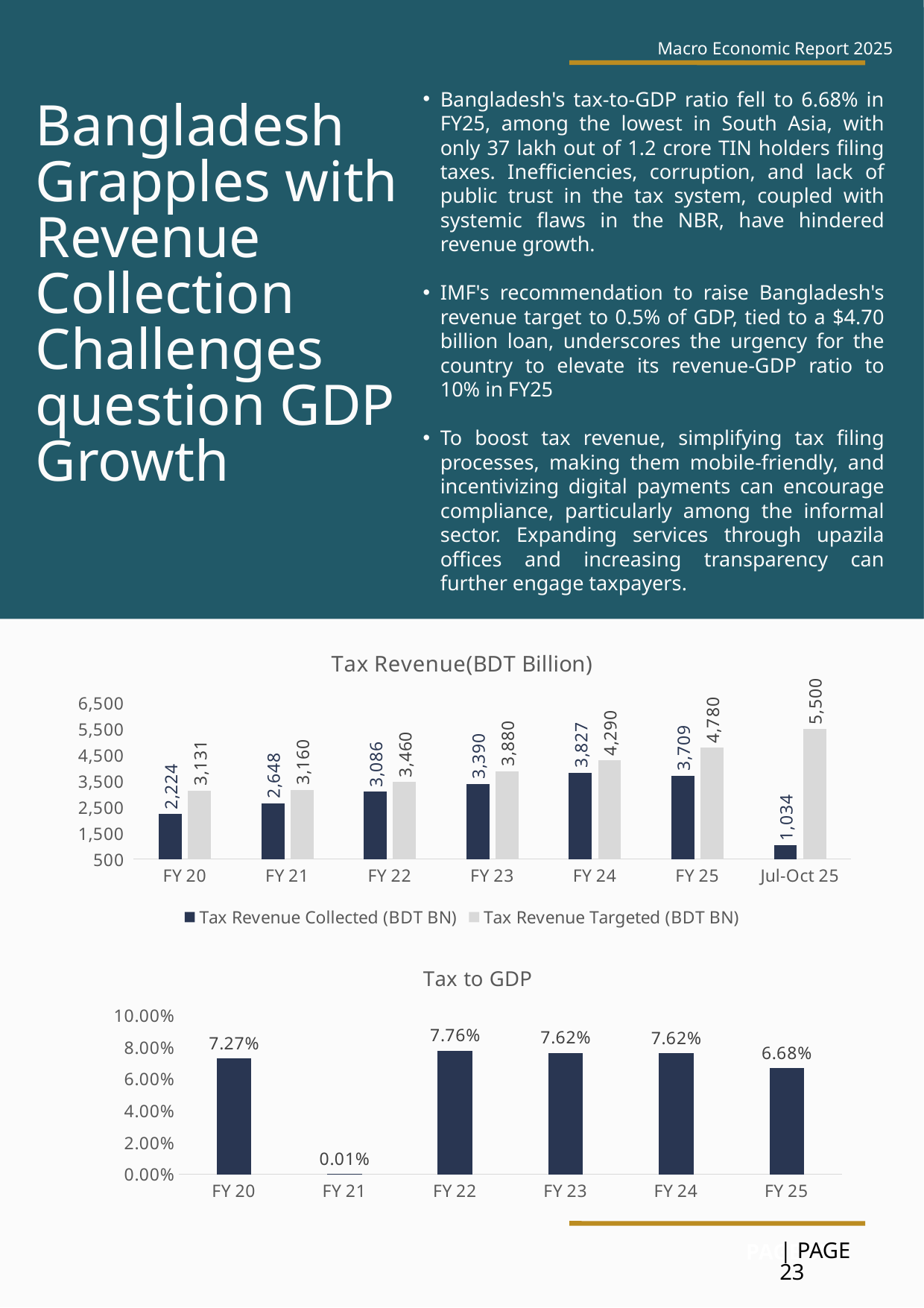
In the Tax Revenue(BDT Billion) chart, which category has the lowest Tax Revenue Collected value? Jul-Oct 25 In the Tax Revenue(BDT Billion) chart, does the Tax Revenue Targeted value rise or fall from FY 20 to Jul-Oct 25? rise In the Tax to GDP chart, what is the value for FY 25? 6.68% In the Tax to GDP chart, which category has the highest value? FY 22 In the Tax Revenue(BDT Billion) chart, what is the Tax Revenue Targeted value for Jul-Oct 25? 5,500 In the Tax Revenue(BDT Billion) chart, which is larger: Tax Revenue Collected in FY 24 or in FY 25? FY 24 In the Tax to GDP chart, what is the difference between the FY 22 value and the FY 25 value? 1.08% What kind of chart is the Tax to GDP chart? bar chart In the Tax Revenue(BDT Billion) chart, what is the difference between Tax Revenue Targeted and Tax Revenue Collected for FY 25? 1,071 In the Tax Revenue(BDT Billion) chart, what is the Tax Revenue Collected value for FY 24? 3,827 How many series does the legend of the Tax Revenue(BDT Billion) chart list? 2 How many categories are shown on the x axis of the Tax Revenue(BDT Billion) chart? 7